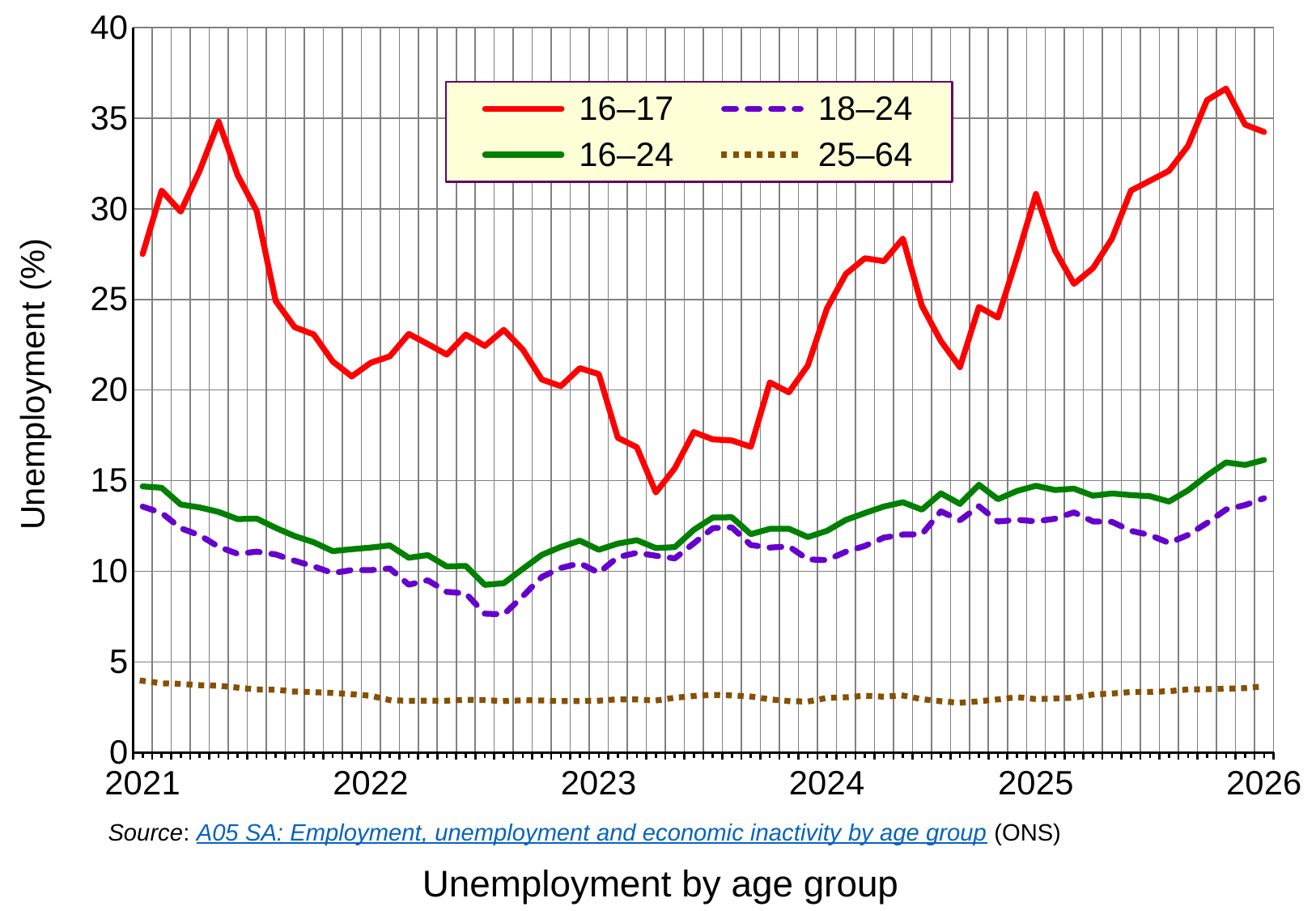
Which series has the higher unemployment rate at the end of the chart in 2026, 16–24 or 18–24? 16–24 Is the unemployment rate for the 25–64 age group ever greater or less than 5 over the whole period? less Is the unemployment rate for the 16–17 age group at the start of 2021 greater or less than 25? greater How many series does the legend list? 4 Does the unemployment rate for the 16–17 age group rise or fall between 2021 and early 2023? fall What kind of chart is shown on the slide? line chart Which age group has the highest unemployment rate throughout the chart? 16–17 What is the title of the chart? Unemployment by age group What is the label on the y axis? Unemployment (%) Which age group has the lowest unemployment rate throughout the chart? 25–64 Is the peak unemployment rate for the 16–17 age group in late 2025 greater or less than 35? greater